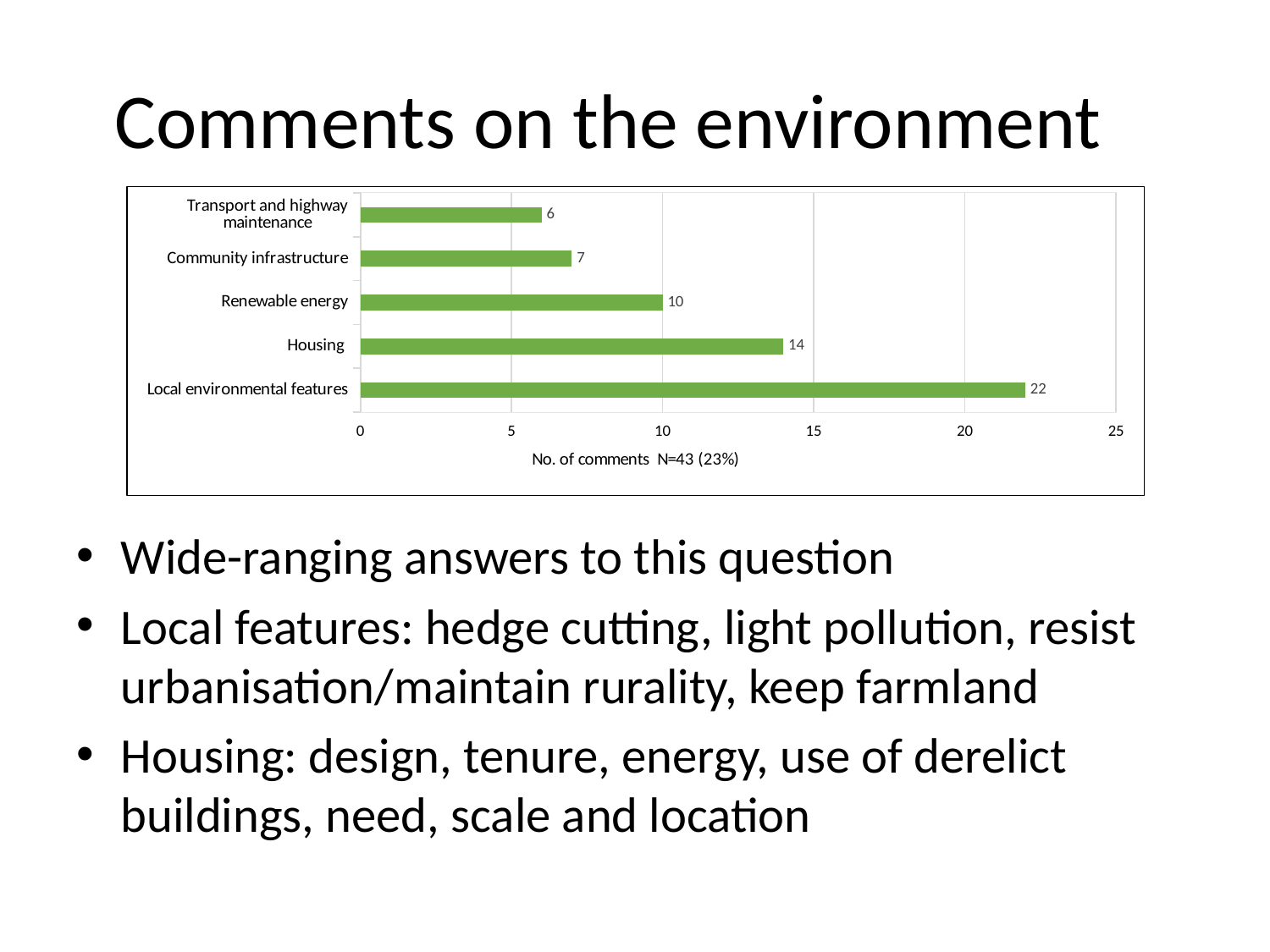
Is the value for Local environmental features greater or less than 20? greater What is the label on the horizontal axis of the chart? No. of comments N=43 (23%) What is the difference in number of comments between Local environmental features and Housing? 8 How many categories are shown in the chart? 5 How many comments does Transport and highway maintenance have? 6 Which has more comments, Renewable energy or Community infrastructure? Renewable energy Which category received the most comments? Local environmental features How many comments were recorded for Housing? 14 What type of chart is shown on the slide? Bar chart What is the number of comments for Renewable energy? 10 What is the difference between the comments for Community infrastructure and Transport and highway maintenance? 1 Which category received the fewest comments? Transport and highway maintenance